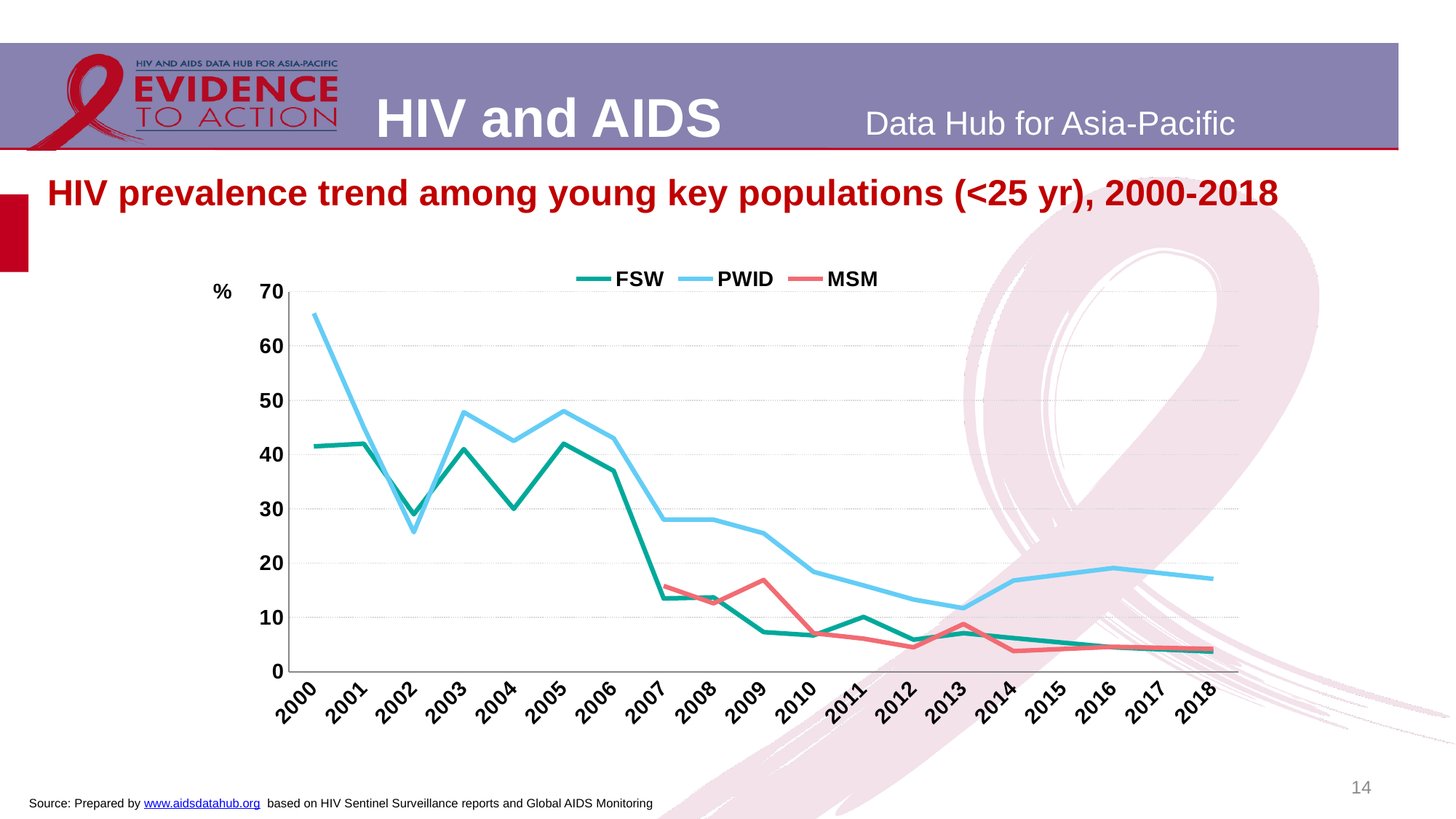
How many years are plotted along the x axis? 19 Is the value for PWID in 2000 greater or less than 60? greater In 2016, which is larger, the value for PWID or the value for MSM? PWID Which series has the highest value in 2018? PWID How many series does the legend list? 3 Is the value for MSM in 2009 greater or less than 10? greater In which year is the PWID series at its highest? 2000 Is the value for FSW in 2018 greater or less than 10? less Does the FSW series rise or fall from 2006 to 2018? fall What kind of chart is shown on the slide? line chart In 2000, which is larger, the value for PWID or the value for FSW? PWID